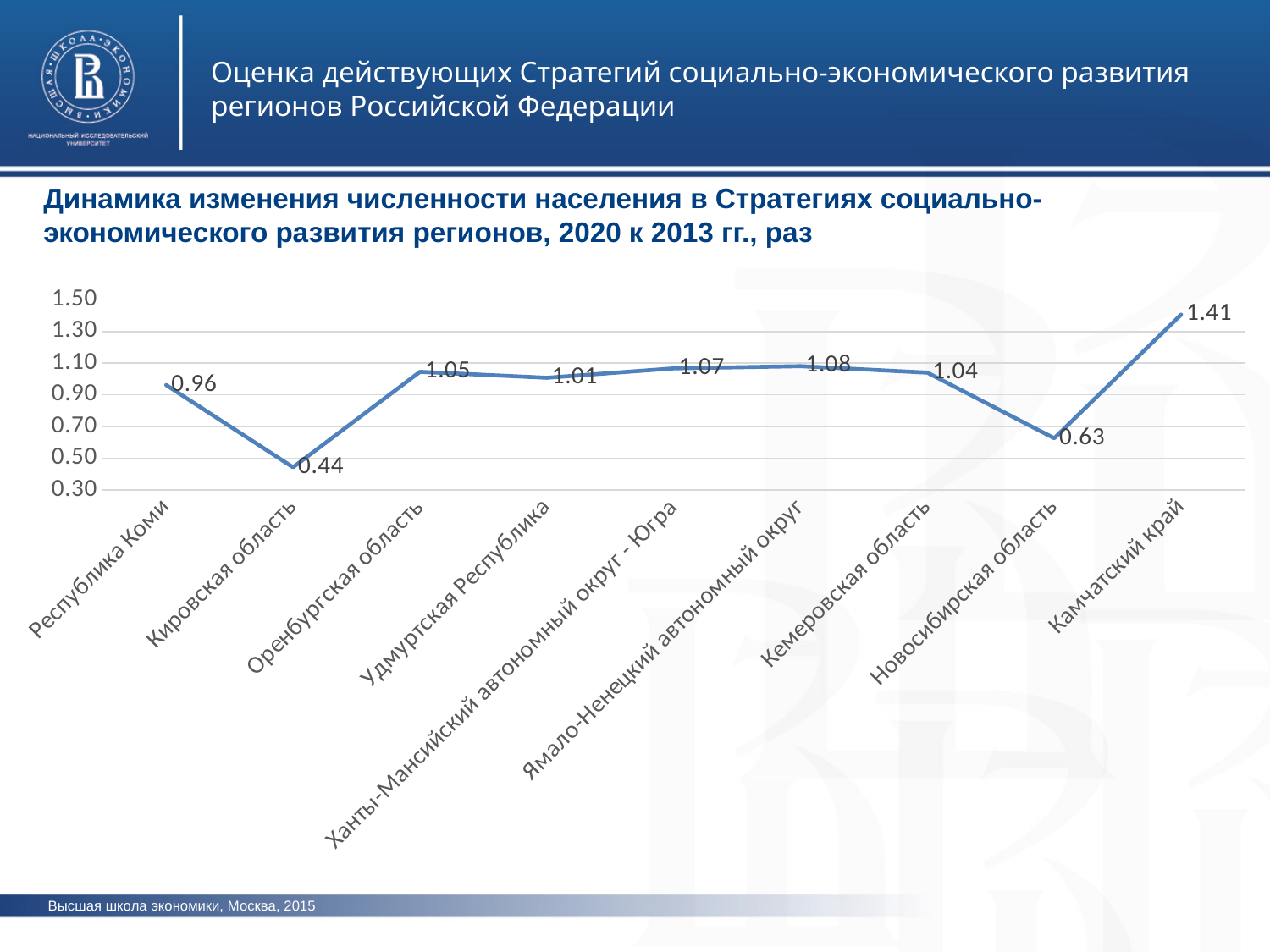
What is the value for Новосибирская область? 0.63 Which is larger, the value for Оренбургская область or the value for Кемеровская область? Оренбургская область What is the difference between the values for Камчатский край and Кировская область? 0.97 Which region has the lowest value? Кировская область How many regions are plotted on the chart? 9 What is the value for Республика Коми? 0.96 What kind of chart is shown on the slide? line chart What is the value for Ямало-Ненецкий автономный округ? 1.08 What is the value for Кировская область? 0.44 What is the difference between the values for Ханты-Мансийский автономный округ - Югра and Удмуртская Республика? 0.06 Which region has the highest value? Камчатский край Is the value for Новосибирская область greater or less than 0.70? less